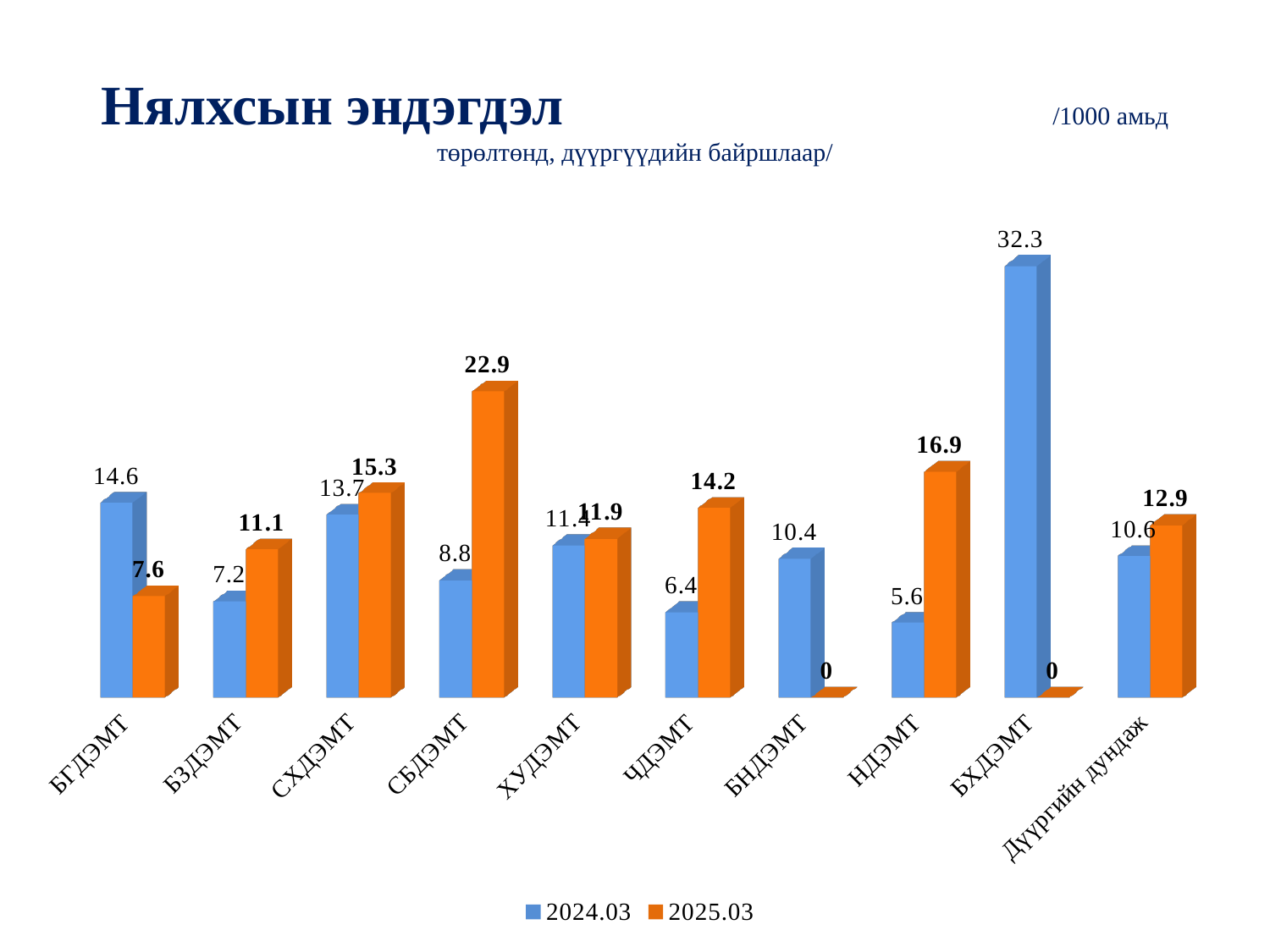
What kind of chart is shown on the slide? Bar chart Which series is shown in orange? 2025.03 Which category has the lowest 2024.03 value? НДЭМТ Which category has the highest 2025.03 value? СБДЭМТ What is the 2024.03 value for БХДЭМТ? 32.3 What is the difference between the 2025.03 and 2024.03 values for СБДЭМТ? 14.1 What is the 2025.03 value for СБДЭМТ? 22.9 What is the 2025.03 value for Дүүргийн дундаж? 12.9 What is the 2024.03 value for НДЭМТ? 5.6 How many series does the legend list? 2 For БГДЭМТ, which series has the larger value, 2024.03 or 2025.03? 2024.03 How many categories are shown on the x axis? 10